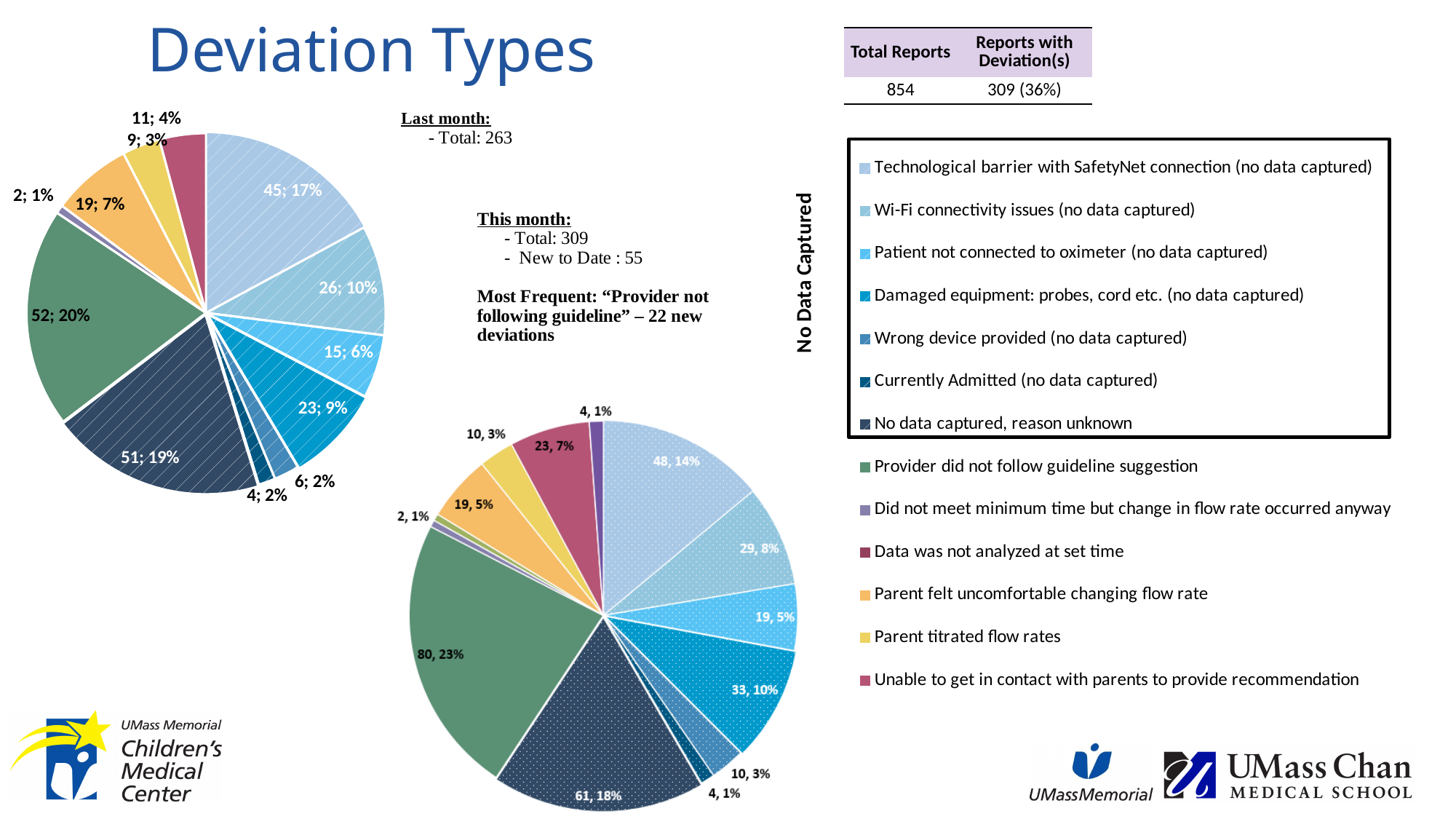
In the last month pie chart, what is the value for 'Technological barrier with SafetyNet connection' (lightest blue slice)? 45 What kind of charts are shown on the slide? Pie charts In the this month pie chart, what is the value for 'No data captured, reason unknown' (dark navy slice)? 61 What is the total number of deviations stated for this month? 309 In the last month pie chart (left), what is the value and share of the largest slice? 52; 20% How many slices does the this month pie chart have? 13 In the this month pie chart, what share does 'Parent felt uncomfortable changing flow rate' (orange slice) represent? 5% In the this month pie chart, what is the value for 'Provider did not follow guideline suggestion' (green slice)? 80 How much did the 'Provider did not follow guideline suggestion' count increase from last month (52) to this month (80)? 28 In the last month pie chart, what is the value and share for 'Parent felt uncomfortable changing flow rate' (orange slice)? 19; 7% In the this month pie chart (lower middle), what is the value and share of the largest slice? 80, 23% In the this month pie chart, which is larger: 'Technological barrier with SafetyNet connection' or 'Wi-Fi connectivity issues'? Technological barrier with SafetyNet connection